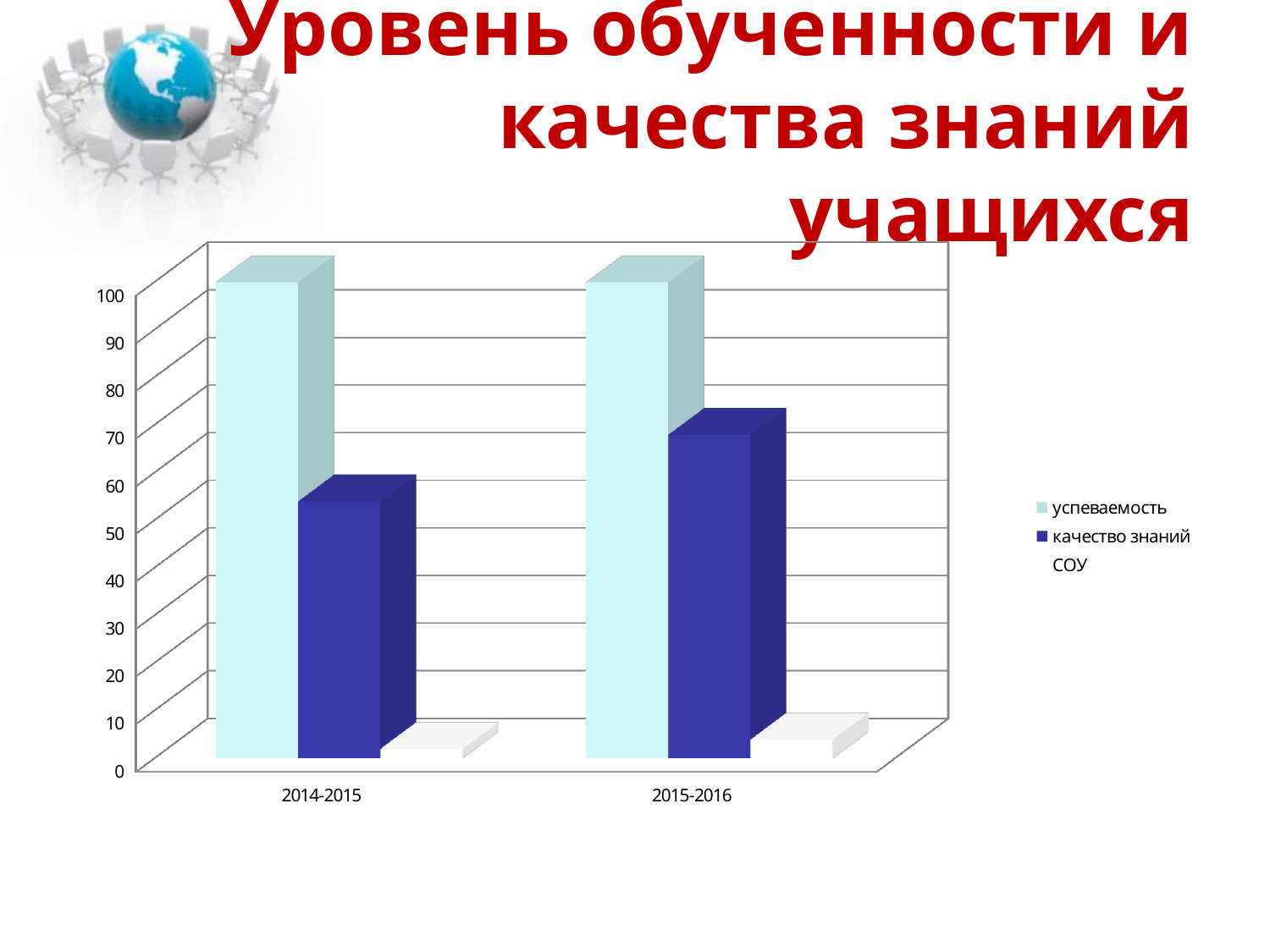
Does the value of качество знаний rise or fall from 2014-2015 to 2015-2016? rise Is the value of качество знаний for 2014-2015 greater or less than 60? less What colour are the bars for the успеваемость series? light blue What are the three entries listed in the chart's legend? успеваемость, качество знаний, СОУ Is the value of успеваемость for 2014-2015 greater or less than 90? greater Which year has the higher value of качество знаний, 2014-2015 or 2015-2016? 2015-2016 How many categories are shown on the x axis of the chart? 2 What kind of chart is shown on the slide? bar chart How many series does the chart's legend list? 3 Is the value of качество знаний for 2015-2016 greater or less than 60? greater Which category has the highest value of качество знаний? 2015-2016 In 2014-2015, which is larger: успеваемость or качество знаний? успеваемость